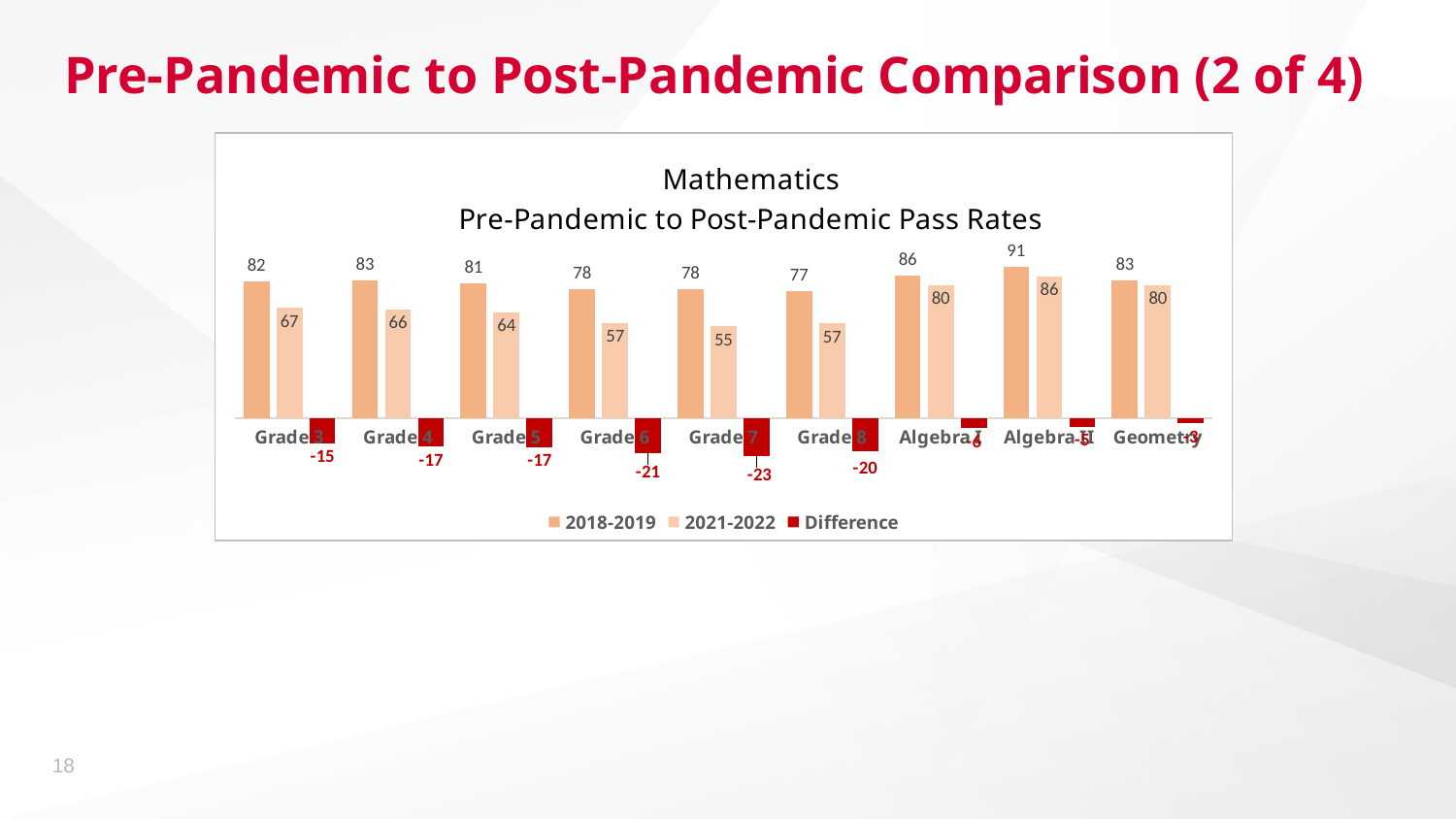
What is the Difference value shown for Grade 6? -21 How many categories are shown on the x axis? 9 What is the difference between the 2018-2019 and 2021-2022 pass rates for Grade 8? 20 What was the 2018-2019 pass rate for Grade 3? 82 What is the 2021-2022 pass rate for Algebra II? 86 What was the 2021-2022 pass rate for Grade 7? 55 What subject does the chart title say the pass rates are for? Mathematics Which is larger, the 2021-2022 pass rate for Algebra I or for Grade 5? Algebra I Which category has the highest 2018-2019 pass rate? Algebra II What kind of chart is shown on the slide? Bar chart How many series does the legend list? 3 Which category has the lowest 2021-2022 pass rate? Grade 7